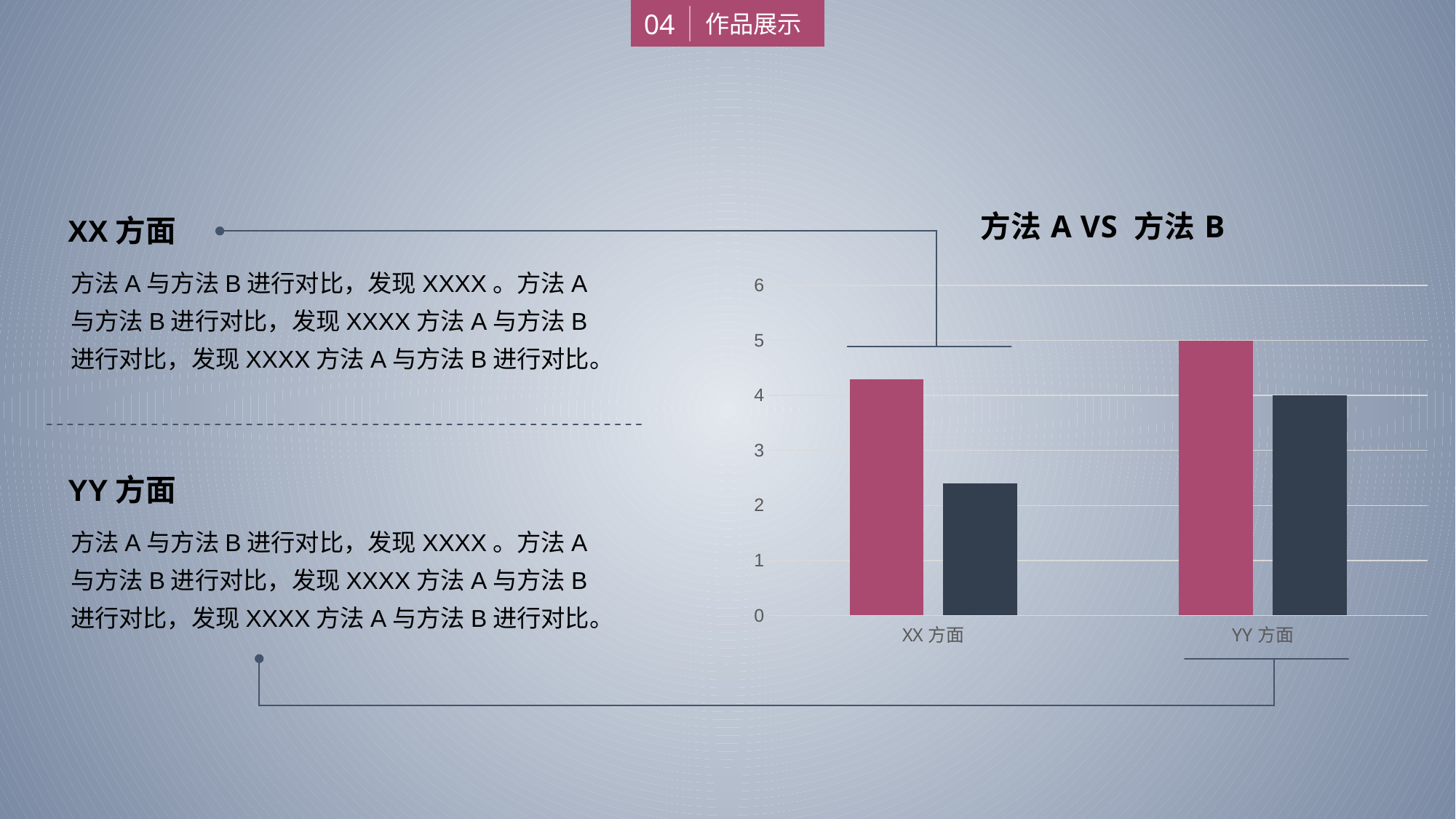
What is the value of the pink bar for YY 方面? 5 Is the value of the pink bar for XX 方面 greater or less than 4? greater What is the title of the chart? 方法 A VS 方法 B How many categories are shown on the x axis of the chart? 2 Which category contains the tallest bar in the chart? YY 方面 Which bar is the shortest in the chart? the dark bar for XX 方面 Is the value of the dark bar for XX 方面 greater or less than 3? less What is the difference between the pink bar and the dark bar for YY 方面? 1 For XX 方面, which bar is taller, the pink bar or the dark bar? the pink bar What is the value of the dark bar for YY 方面? 4 Do the pink bars rise or fall from XX 方面 to YY 方面? rise What kind of chart is shown under the title 方法 A VS 方法 B? bar chart